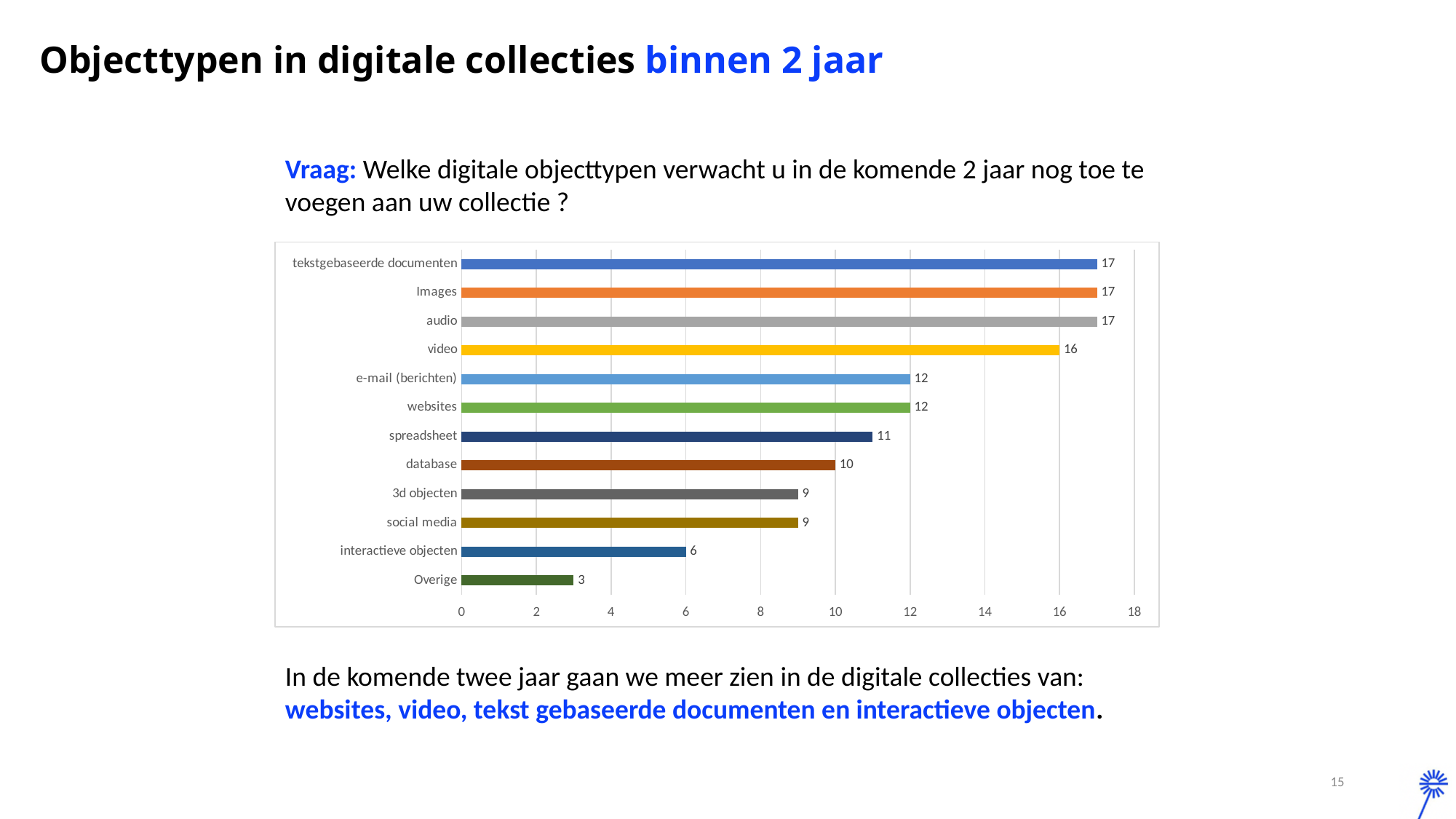
What kind of chart is shown on the slide? bar chart What is the value for video? 16 Which category has the lowest value? Overige Is the value for social media greater or less than 10? less What is the value for spreadsheet? 11 What is the value for interactieve objecten? 6 What is the difference between the values for e-mail (berichten) and interactieve objecten? 6 How many categories are shown in the chart? 12 What is the difference between the values for video and Overige? 13 Which is larger, the value for database or the value for 3d objecten? database What is the value for database? 10 What is the maximum value shown on the horizontal axis? 18